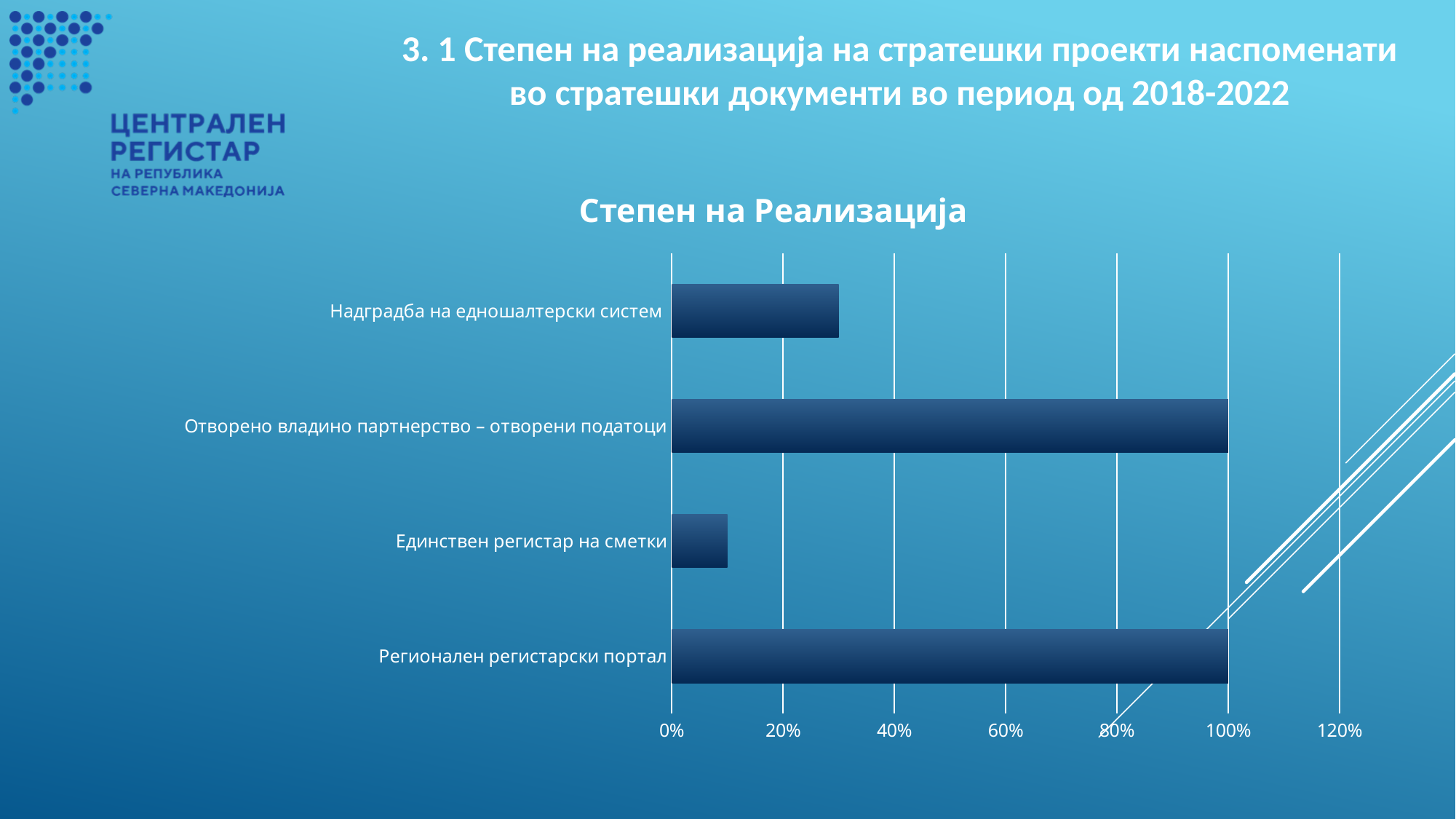
Is the value for Единствен регистар на сметки greater or less than 20%? less What is the value for Регионален регистарски портал? 100% What is the title of the chart? Степен на Реализација Which is larger: the value for Регионален регистарски портал or the value for Надградба на едношалтерски систем? Регионален регистарски портал What is the highest value shown on the horizontal axis of the chart? 120% Is the value for Надградба на едношалтерски систем greater or less than 40%? less Which category has the lowest value? Единствен регистар на сметки How many categories are plotted in the chart? 4 Is the value for Надградба на едношалтерски систем greater or less than 20%? greater What is the value for Отворено владино партнерство – отворени податоци? 100% What kind of chart is shown on the slide? bar chart Which is larger: the value for Надградба на едношалтерски систем or the value for Единствен регистар на сметки? Надградба на едношалтерски систем